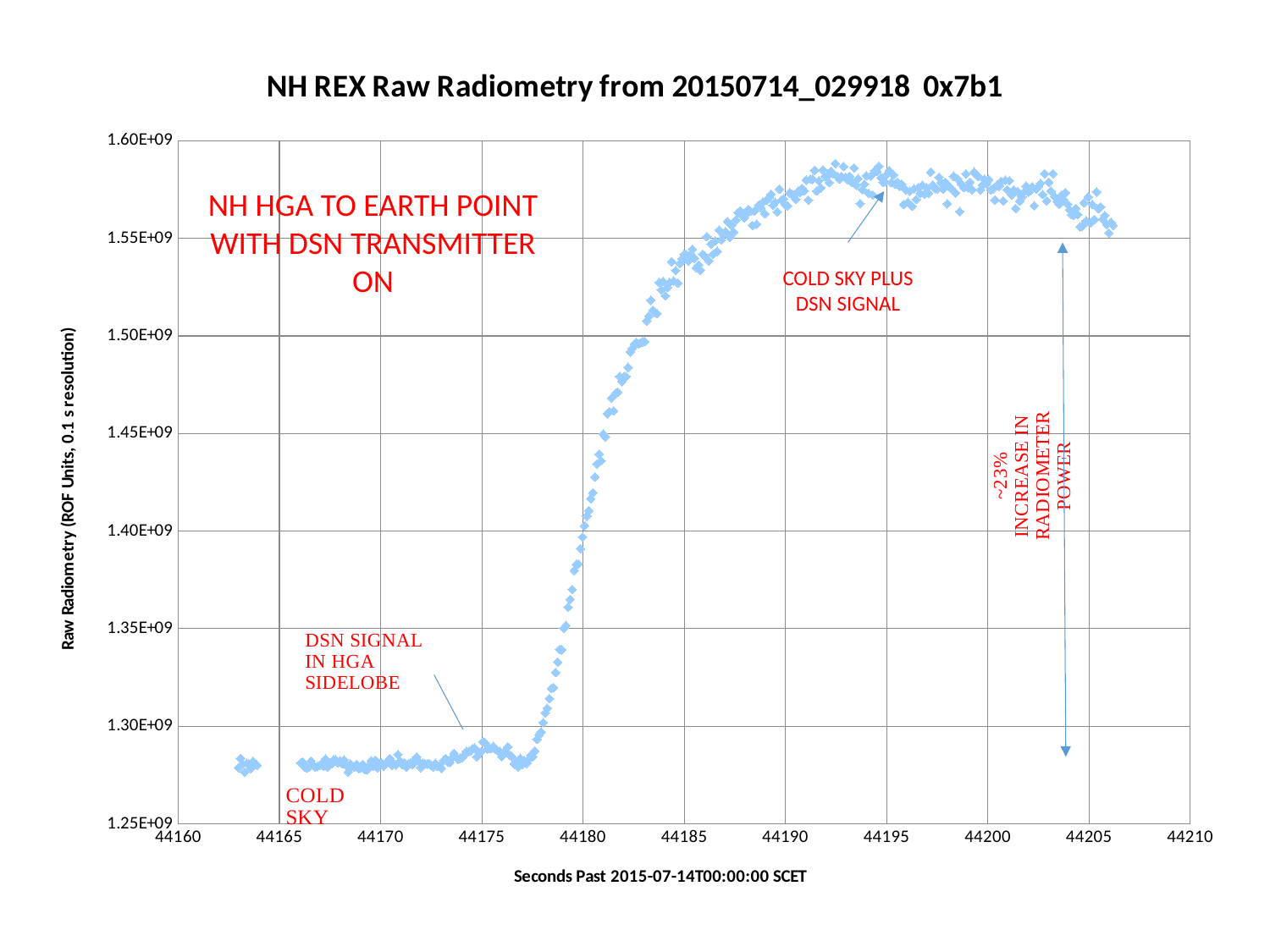
Is the value plotted at about 44185 seconds greater or less than 1.50E+09? greater Is the value plotted at about 44195 seconds greater or less than 1.55E+09? greater What kind of chart is shown on the slide? scatter chart What is the title of the chart? NH REX Raw Radiometry from 20150714_029918 0x7b1 Is the lowest plotted value greater or less than 1.30E+09? less Which is larger, the value plotted at about 44200 seconds or the value at about 44165 seconds? 44200 seconds According to the annotation on the chart, by approximately what percentage does the radiometer power increase? ~23% Which is larger, the value plotted at about 44170 seconds or the value at about 44190 seconds? 44190 seconds Do the plotted values overall rise or fall as the x axis increases from 44160 to 44210? rise